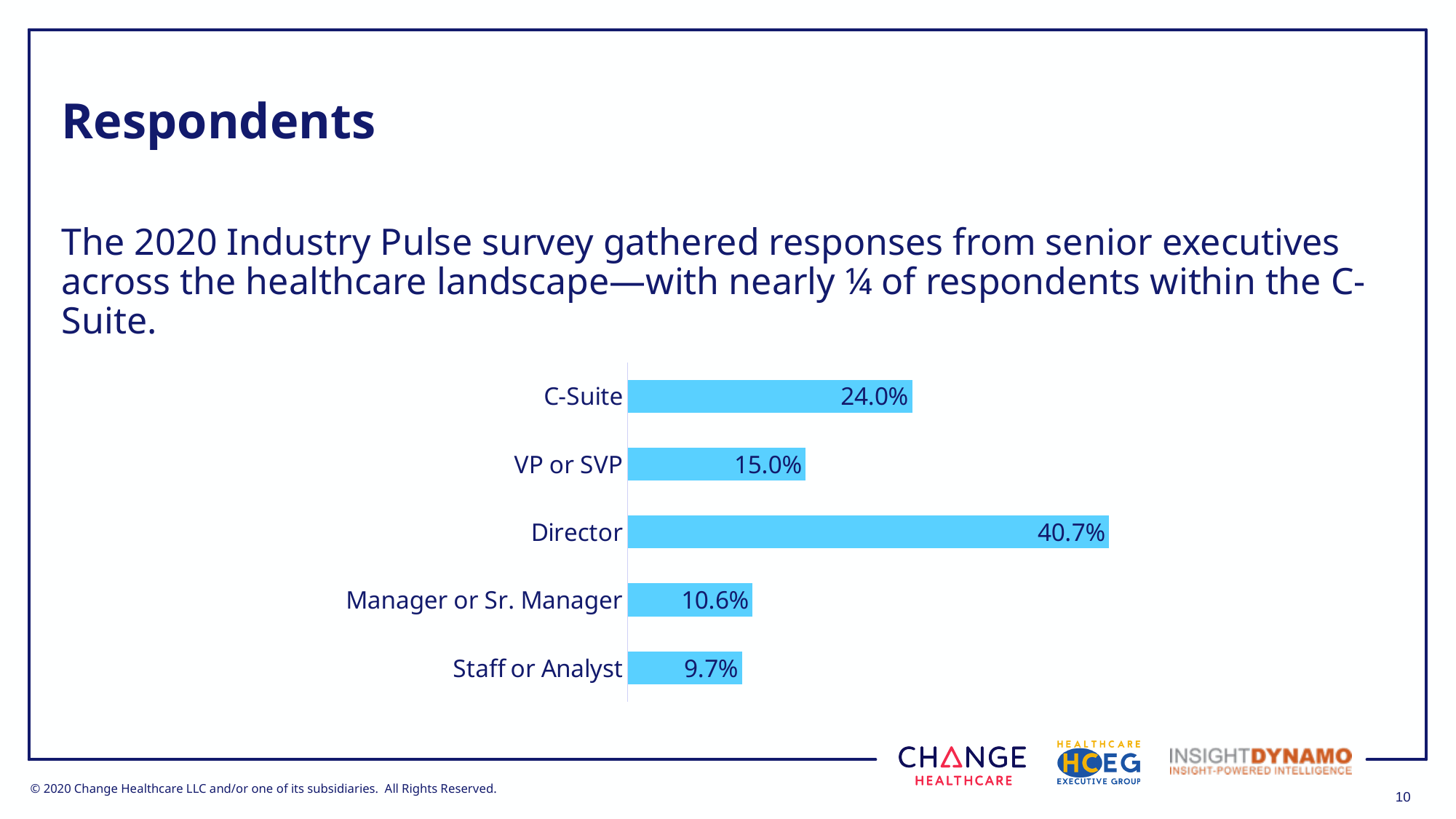
Which category has the lowest value? Staff or Analyst What percentage of respondents are in the C-Suite? 24.0% What percentage of respondents are Staff or Analyst? 9.7% What is the value for Manager or Sr. Manager? 10.6% What is the difference between the VP or SVP and Staff or Analyst values? 5.3% What is the title of the slide containing the chart? Respondents What is the difference between the Director and C-Suite values? 16.7% What kind of chart is shown on the slide? Bar chart What is the value for Director? 40.7% How many categories are shown in the chart? 5 Which category has the highest value? Director Which is larger, the value for C-Suite or the value for VP or SVP? C-Suite